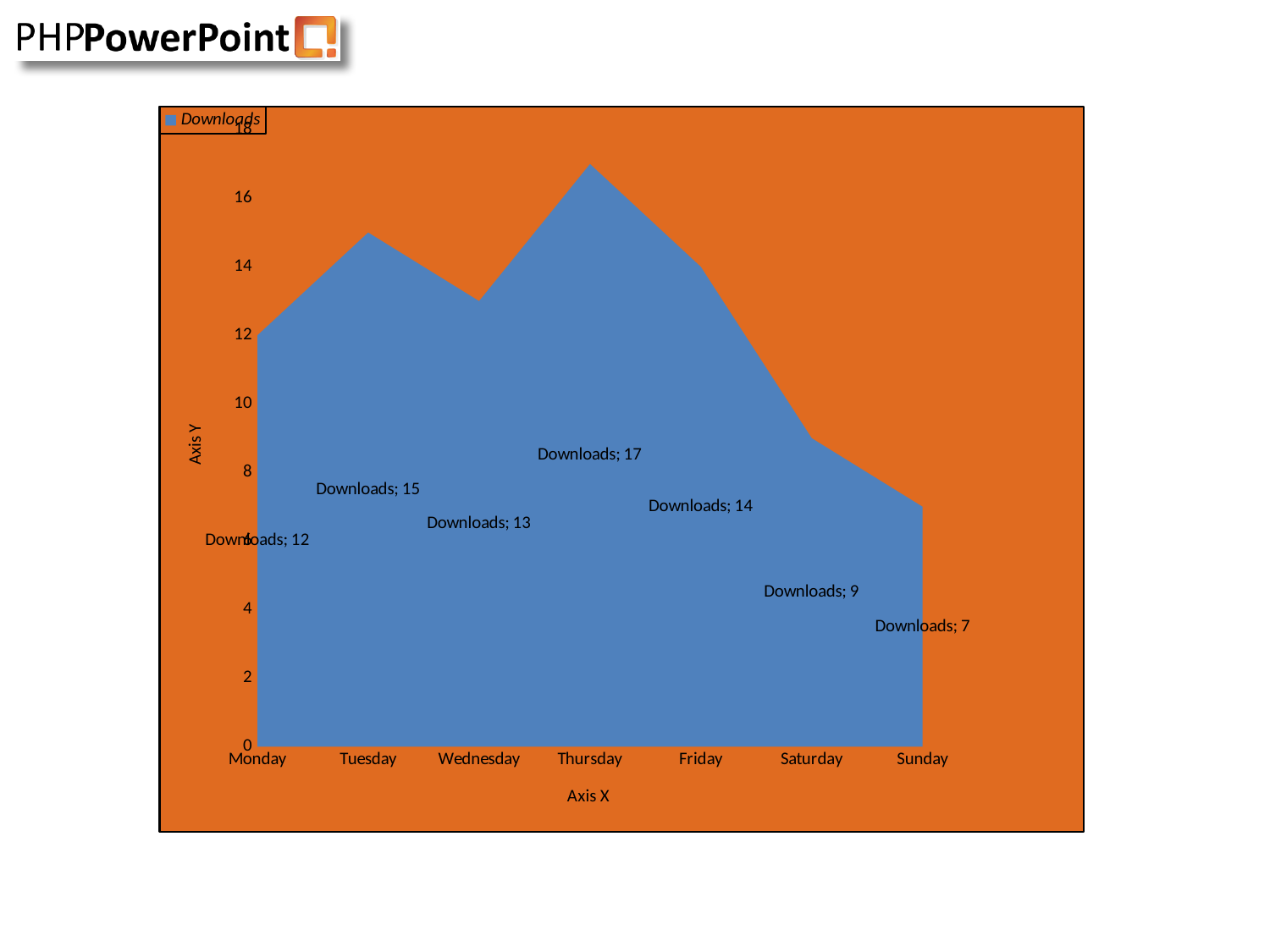
Which has a larger Downloads value, Tuesday or Friday? Tuesday How many series does the legend list? 1 Which day has the lowest Downloads value? Sunday What is the Downloads value for Tuesday? 15 What kind of chart is shown on the slide? area chart What is the difference between the Downloads values for Thursday and Sunday? 10 What is the title of the vertical axis? Axis Y What is the Downloads value for Sunday? 7 Which day has the highest Downloads value? Thursday What is the Downloads value for Thursday? 17 Is the Downloads value for Saturday greater or less than 10? less How many days are shown on the x axis? 7